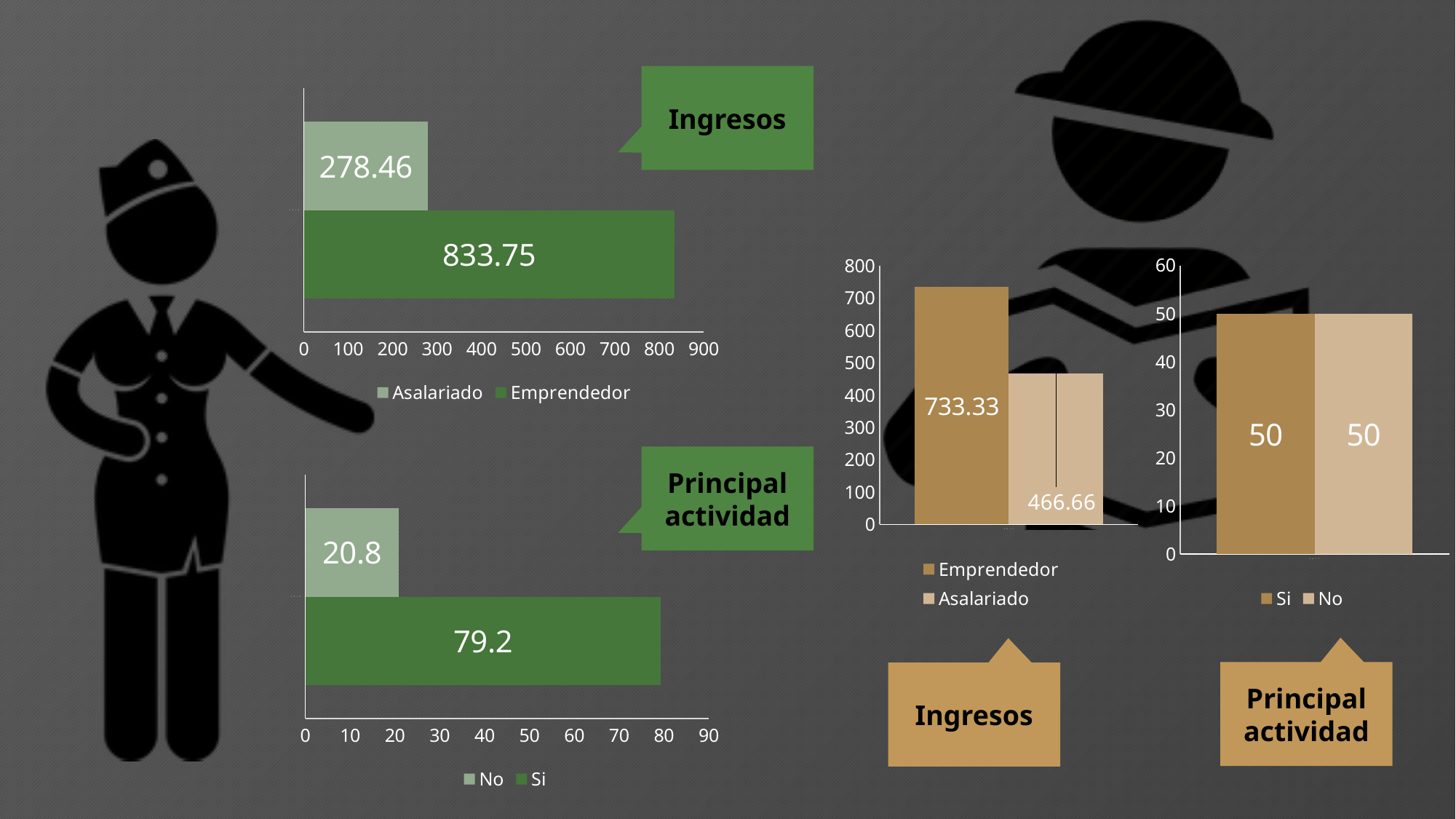
In the brown Principal actividad chart on the right, what is the value for No? 50 How many series does the legend of the brown Ingresos chart on the right list? 2 In the green Principal actividad chart on the left, which series has the lower value? No In the brown Ingresos chart on the right, what is the value for Asalariado? 466.66 What type of chart is the green Ingresos chart on the left? Bar chart In the green Principal actividad chart on the left, what is the value for Si? 79.2 In the green Ingresos chart on the left, what is the difference between the Emprendedor and Asalariado values? 555.29 In the green Ingresos chart on the left, what is the value for Asalariado? 278.46 In the green Principal actividad chart on the left, what is the total of the No and Si values? 100 In the green Ingresos chart on the left, what is the value for Emprendedor? 833.75 In the brown Ingresos chart on the right, what is the difference between Emprendedor and Asalariado? 266.67 In the brown Ingresos chart on the right, which series has the higher value? Emprendedor